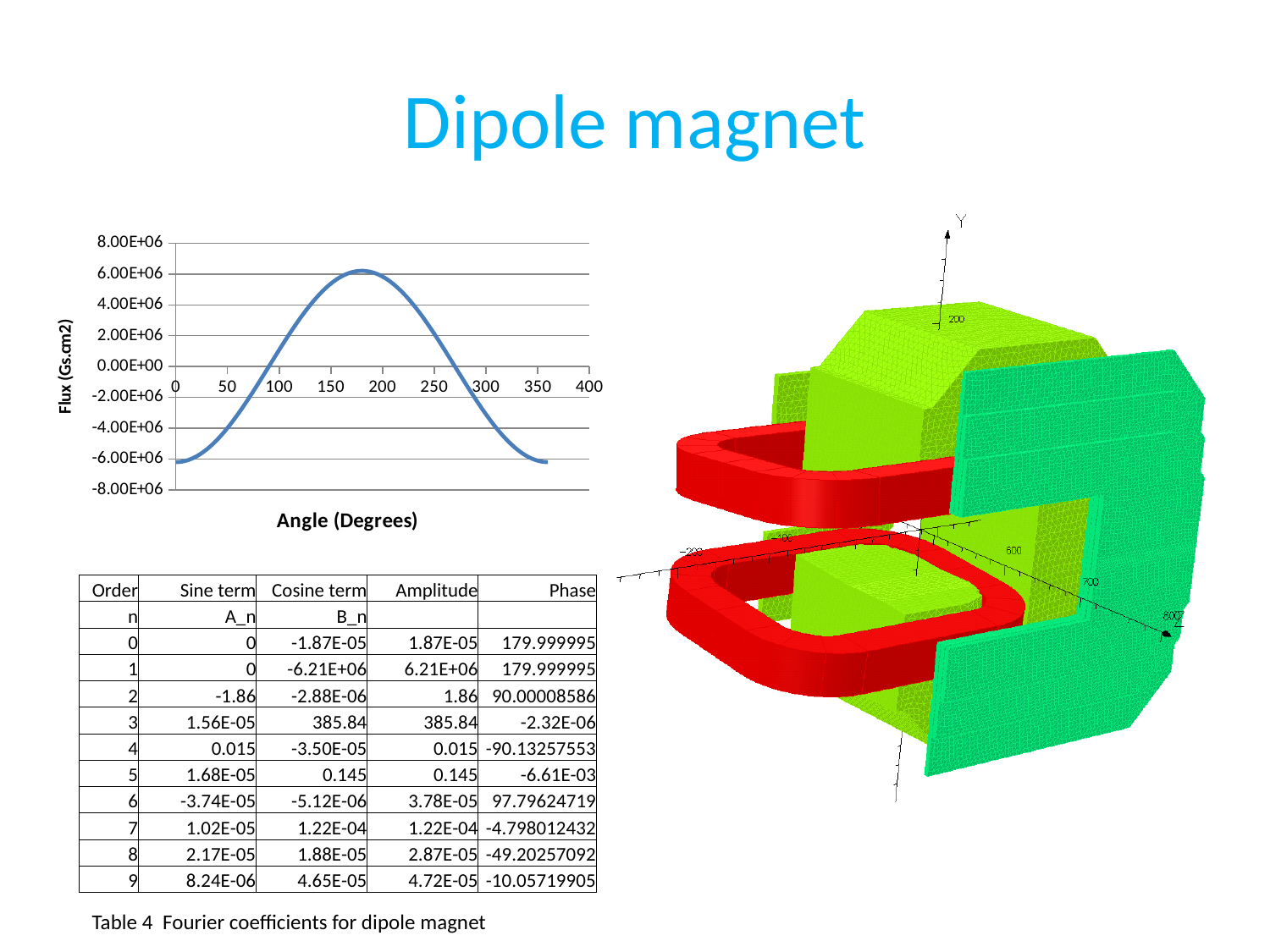
Does the flux rise or fall as the angle increases from 0 to 150 degrees? rise Which has the larger flux value, an angle of 150 degrees or an angle of 50 degrees? 150 degrees Is the flux at an angle of 250 degrees greater or less than 0.00E+00? greater What is the title of the horizontal axis of the chart? Angle (Degrees) What is the title of the vertical axis of the chart? Flux (Gs.cm2) Does the flux rise or fall as the angle increases from 200 to 350 degrees? fall Is the flux at an angle of 350 degrees greater or less than -4.00E+06? less What is the highest value shown on the vertical axis of the chart? 8.00E+06 What kind of chart is shown on the left of the slide? line chart Which has the larger flux value, an angle of 100 degrees or an angle of 300 degrees? 100 degrees Is the flux at an angle of 150 degrees greater or less than 2.00E+06? greater